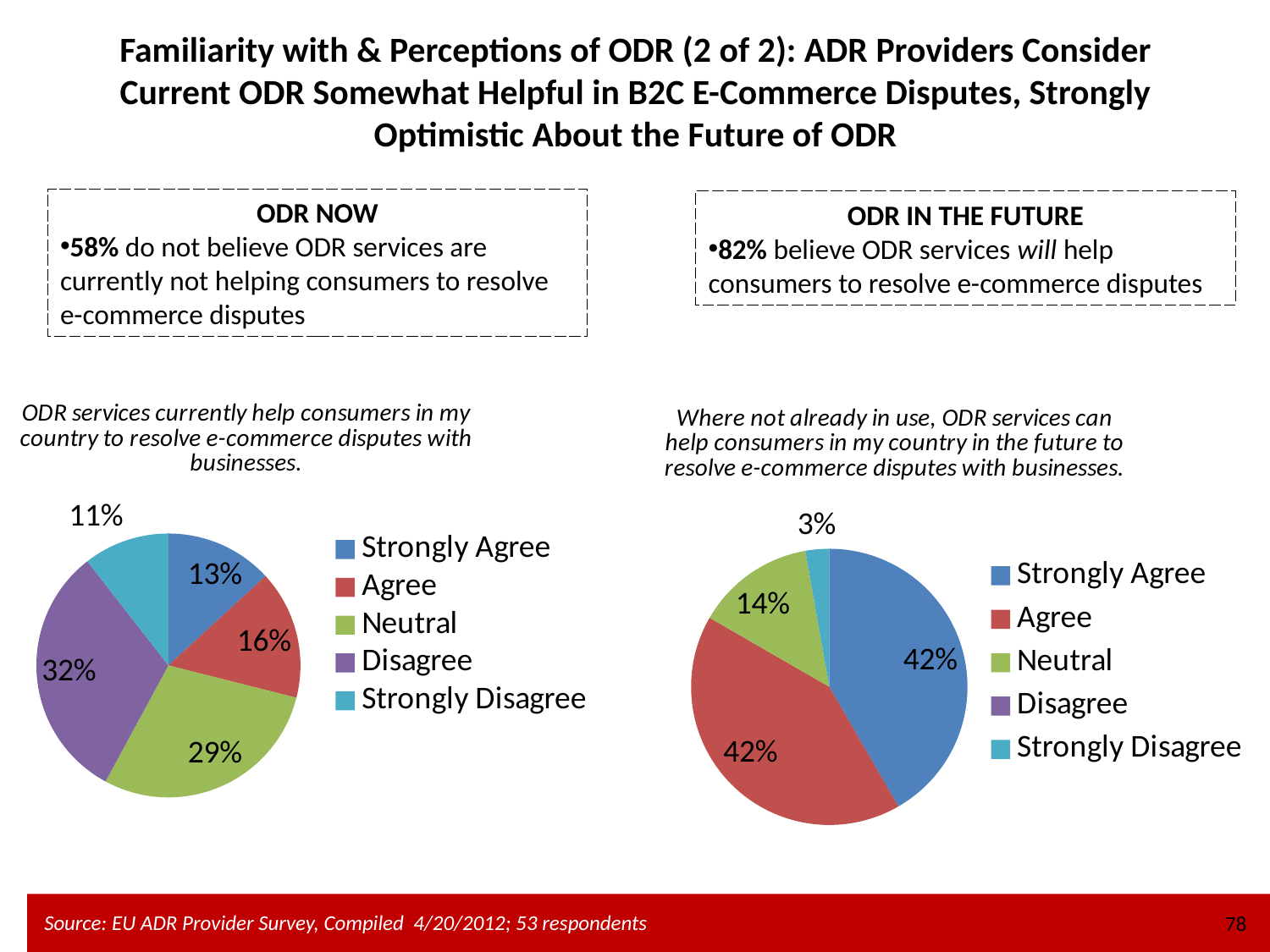
In the left pie chart (ODR services currently help consumers), what is the difference between the Disagree and Agree shares? 16% In the left pie chart (ODR services currently help consumers), what percentage is Strongly Agree? 13% In the right pie chart (ODR services can help consumers in the future), what percentage is Strongly Disagree? 3% In the left pie chart (ODR services currently help consumers), what percentage is Neutral? 29% In the left pie chart (ODR services currently help consumers), what percentage is Disagree? 32% In the left pie chart (ODR services currently help consumers), which category has the smallest share? Strongly Disagree In the left pie chart (ODR services currently help consumers), which is larger, Neutral or Agree? Neutral In the right pie chart (ODR services can help consumers in the future), what percentage is Strongly Agree? 42% What kind of chart is the left chart on the slide? pie chart In the left pie chart (ODR services currently help consumers), which category has the largest share? Disagree How many entries does the legend of the right pie chart list? 5 In the right pie chart (ODR services can help consumers in the future), what percentage is Neutral? 14%